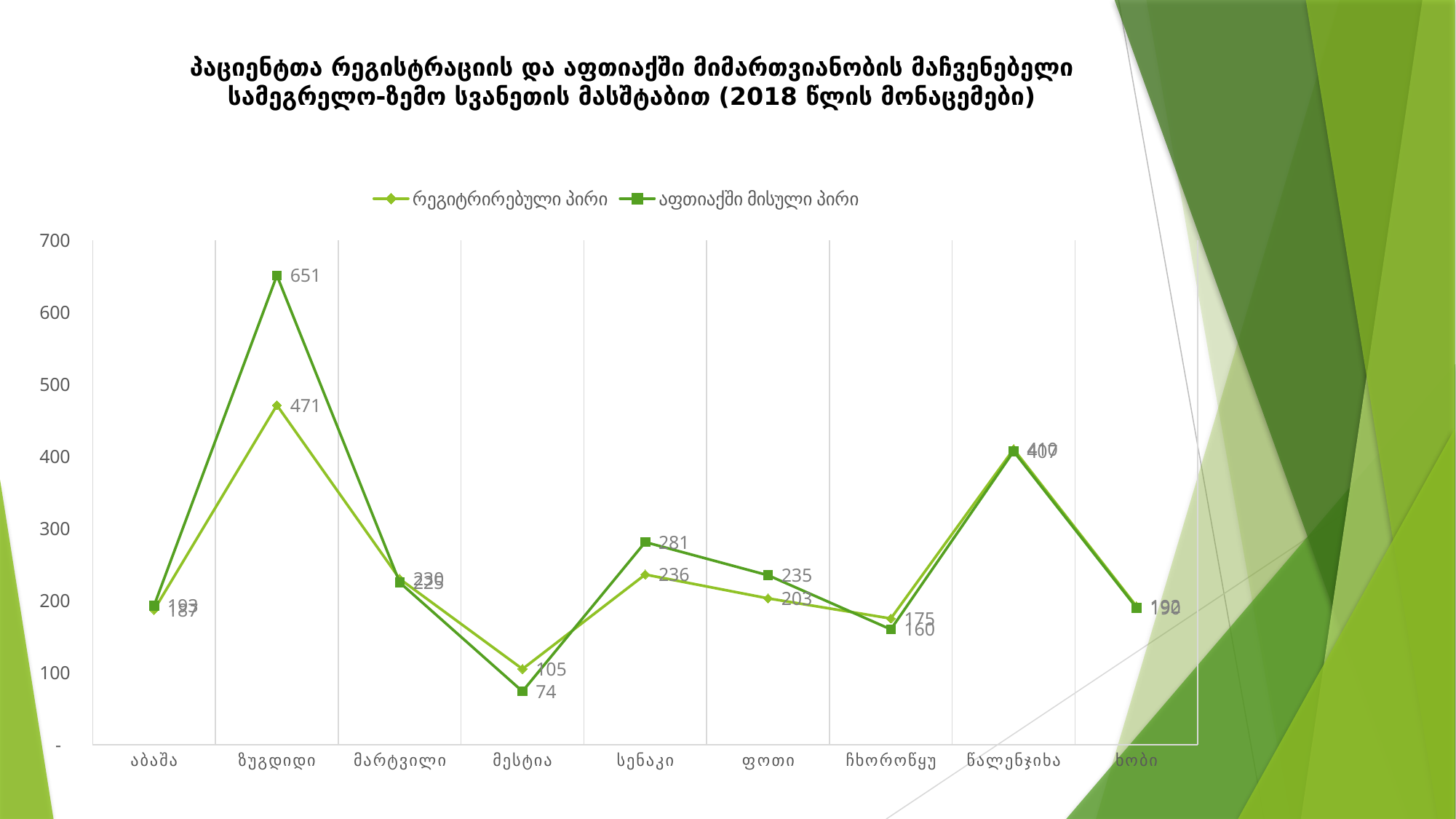
What is the value for სენაკი in the რეგიტრირებული პირი series? 236 Is the value for ხობი in the აფთიაქში მისული პირი series greater or less than 100? greater How many categories are shown on the x axis? 9 Which category has the highest value in the აფთიაქში მისული პირი series? ზუგდიდი What type of chart is shown on the slide? line chart Which category has the lowest value in the რეგიტრირებული პირი series? მესტია How many series does the legend list? 2 What is the difference between the აფთიაქში მისული პირი and რეგიტრირებული პირი values for ზუგდიდი? 180 What is the value for ზუგდიდი in the აფთიაქში მისული პირი series? 651 For ფოთი, which series has the larger value: რეგიტრირებული პირი or აფთიაქში მისული პირი? აფთიაქში მისული პირი What is the value for მესტია in the აფთიაქში მისული პირი series? 74 What is the value for ზუგდიდი in the რეგიტრირებული პირი series? 471